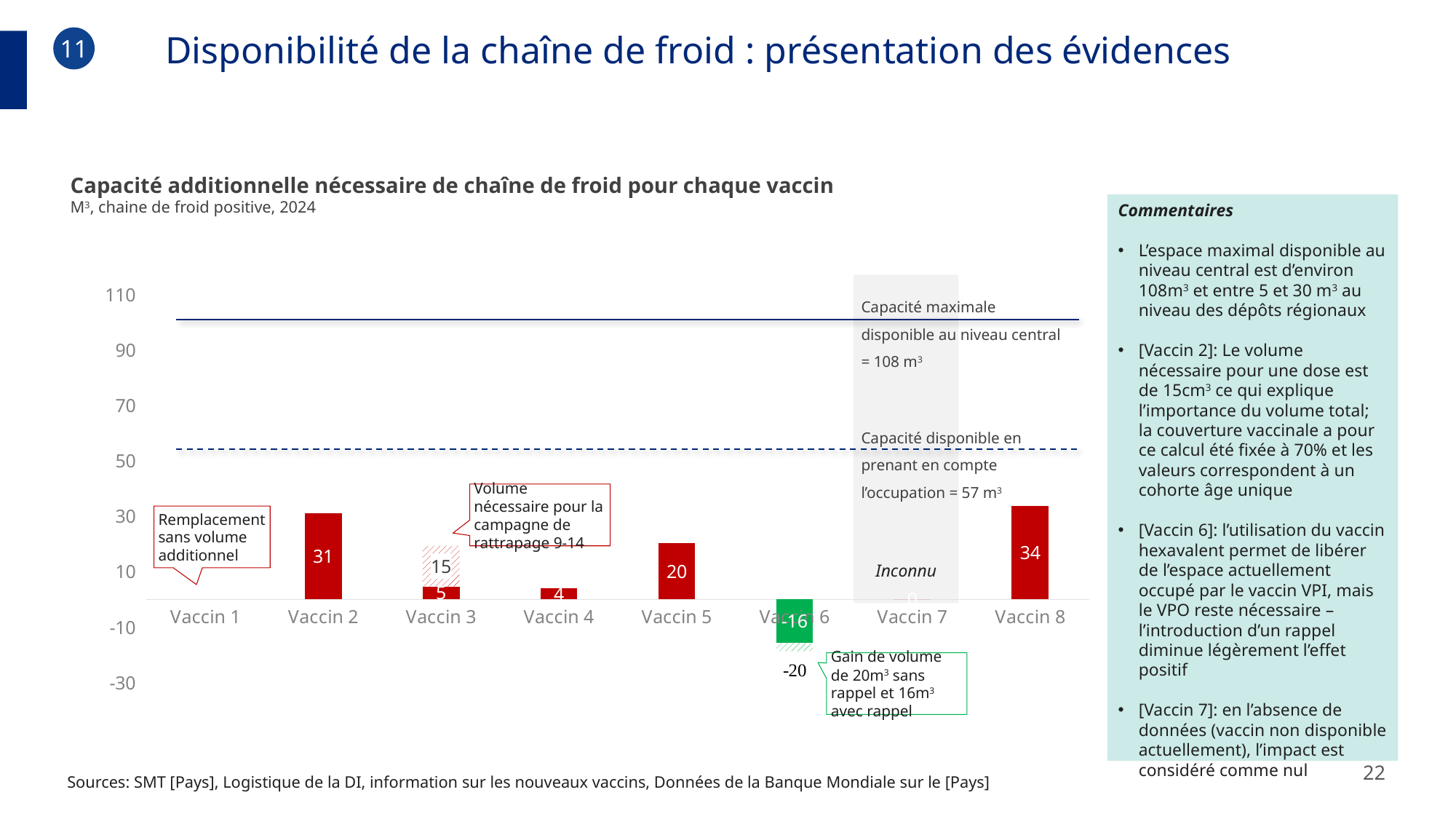
What is the difference between the values for Vaccin 8 and Vaccin 2? 3 What is the value shown for Vaccin 2? 31 Which has a larger value, Vaccin 5 or Vaccin 4? Vaccin 5 What kind of chart is shown on the slide? bar chart What is the value shown for Vaccin 8? 34 Is the value for Vaccin 2 greater or less than 50? less What is the maximum capacity available at the central level, as indicated by the solid reference line? 108 m³ What is the value shown for Vaccin 4? 4 Which vaccine has the lowest value on the chart? Vaccin 6 What is the value shown for Vaccin 5? 20 How many vaccine categories are shown on the x axis? 8 Which vaccine has the highest additional cold chain capacity requirement? Vaccin 8